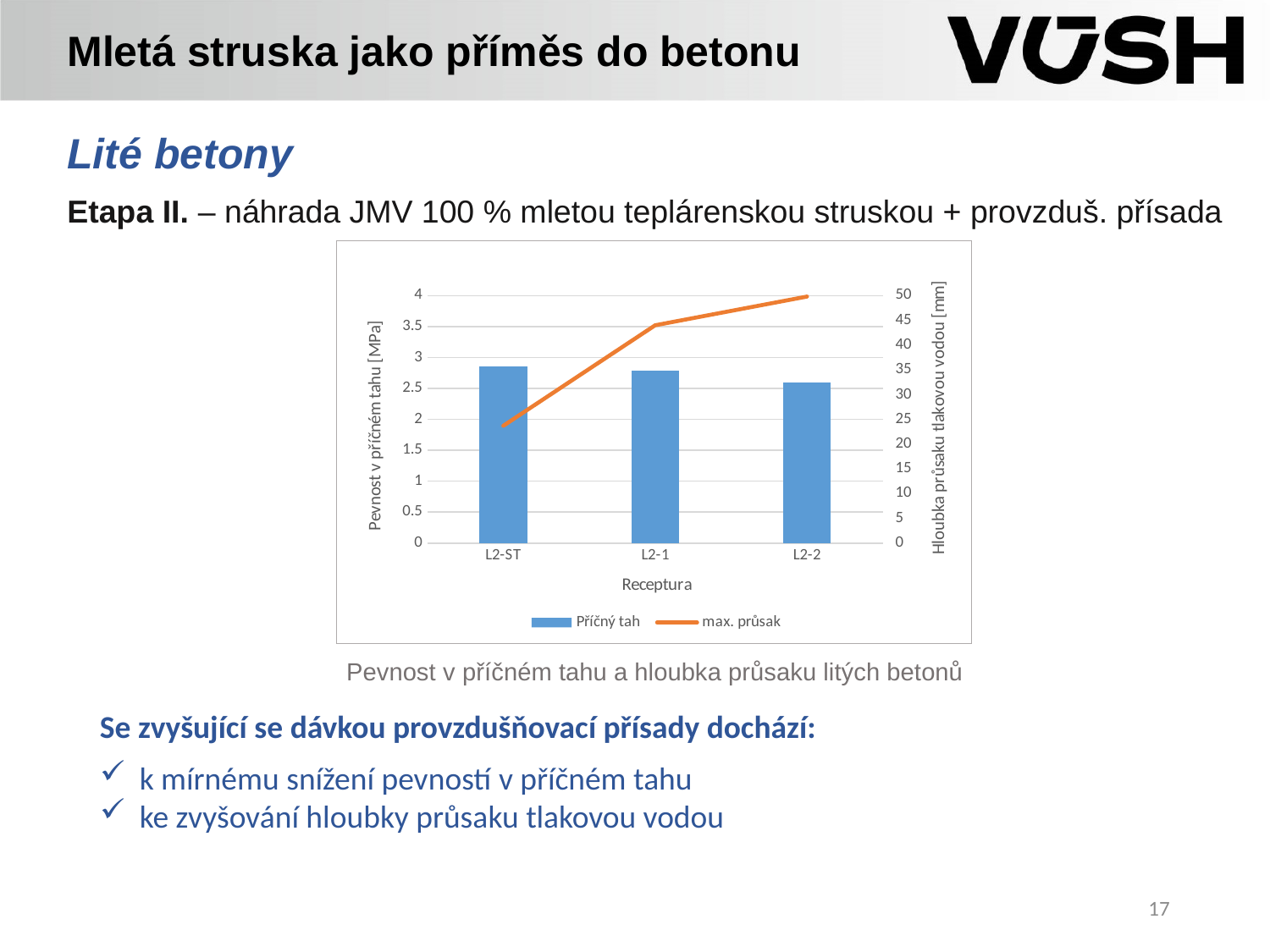
Is the Příčný tah value for L2-2 greater or less than 2.5? greater How many categories (recipes) are shown on the x axis of the chart? 3 What is the label of the left vertical axis of the chart? Pevnost v příčném tahu [MPa] What kind of chart is shown on the slide? A combined bar and line chart Is the Příčný tah value for L2-ST greater or less than 3? less Which recipe has the lowest max. průsak (line) value? L2-ST Which recipe has the lowest Příčný tah (bar) value? L2-2 Which recipe has the highest max. průsak (line) value? L2-2 Is the max. průsak value for L2-ST greater or less than 30? less How many series does the chart legend list? 2 Does the max. průsak line rise or fall from L2-ST to L2-2? rise